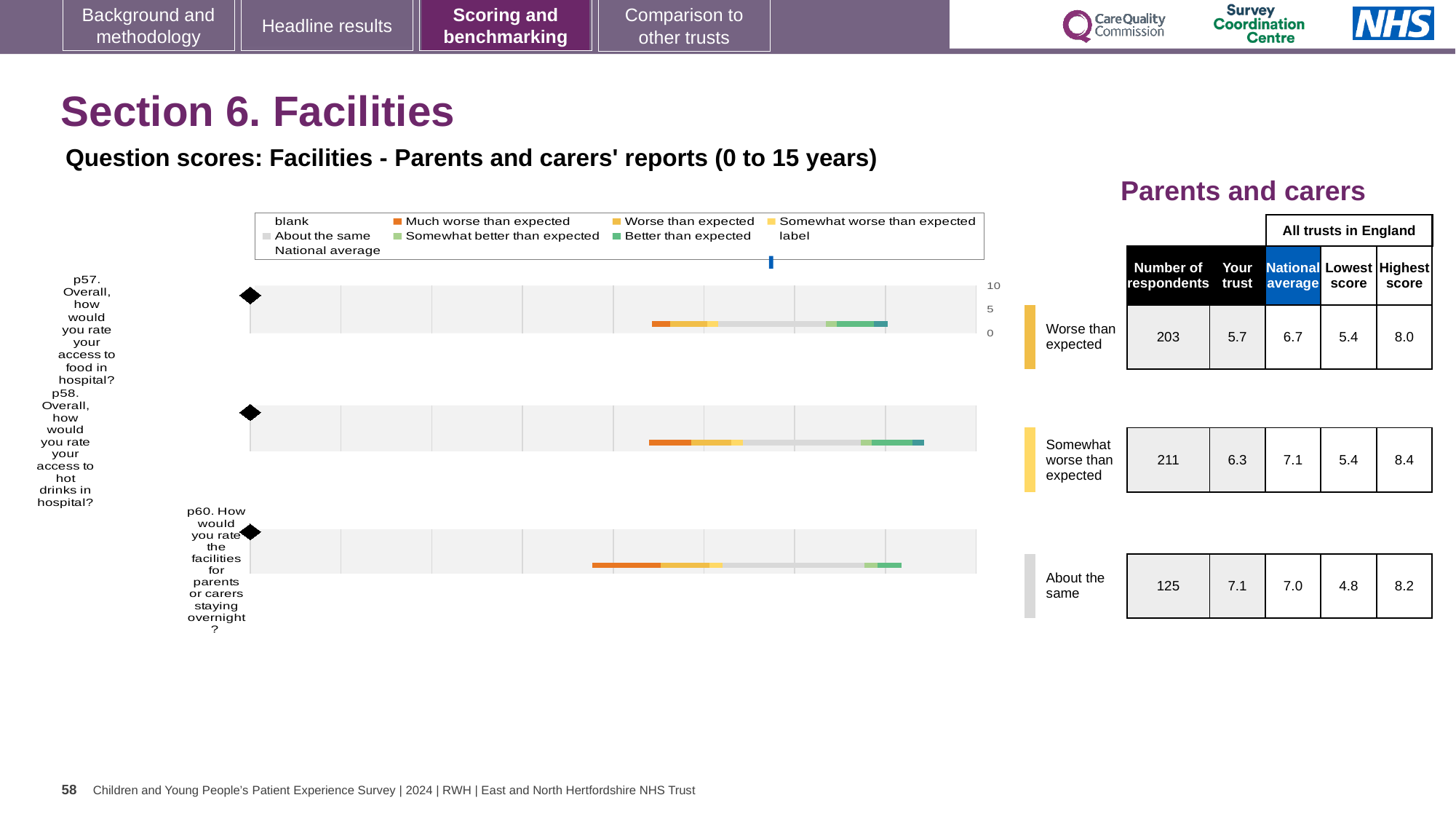
What is the highest score across all trusts in England for p58? 8.4 How many respondents answered p60 (facilities for parents or carers staying overnight)? 125 Which benchmark category is p57 placed in? Worse than expected Which question has the highest 'Your trust' score? p60 What is the national average score for p58 (access to hot drinks in hospital)? 7.1 How many questions (p57, p58, p60) are plotted as separate bars on the slide? 3 What is the 'Your trust' score for p57 (access to food in hospital)? 5.7 What kind of chart is used to show the question scores for p57, p58 and p60? bar chart For p57, how much lower is the trust's score than the national average? 1.0 For p60, which is larger: the trust's score or the national average? Your trust Which question has the lowest 'Your trust' score? p57 Which benchmark category is p58 placed in? Somewhat worse than expected